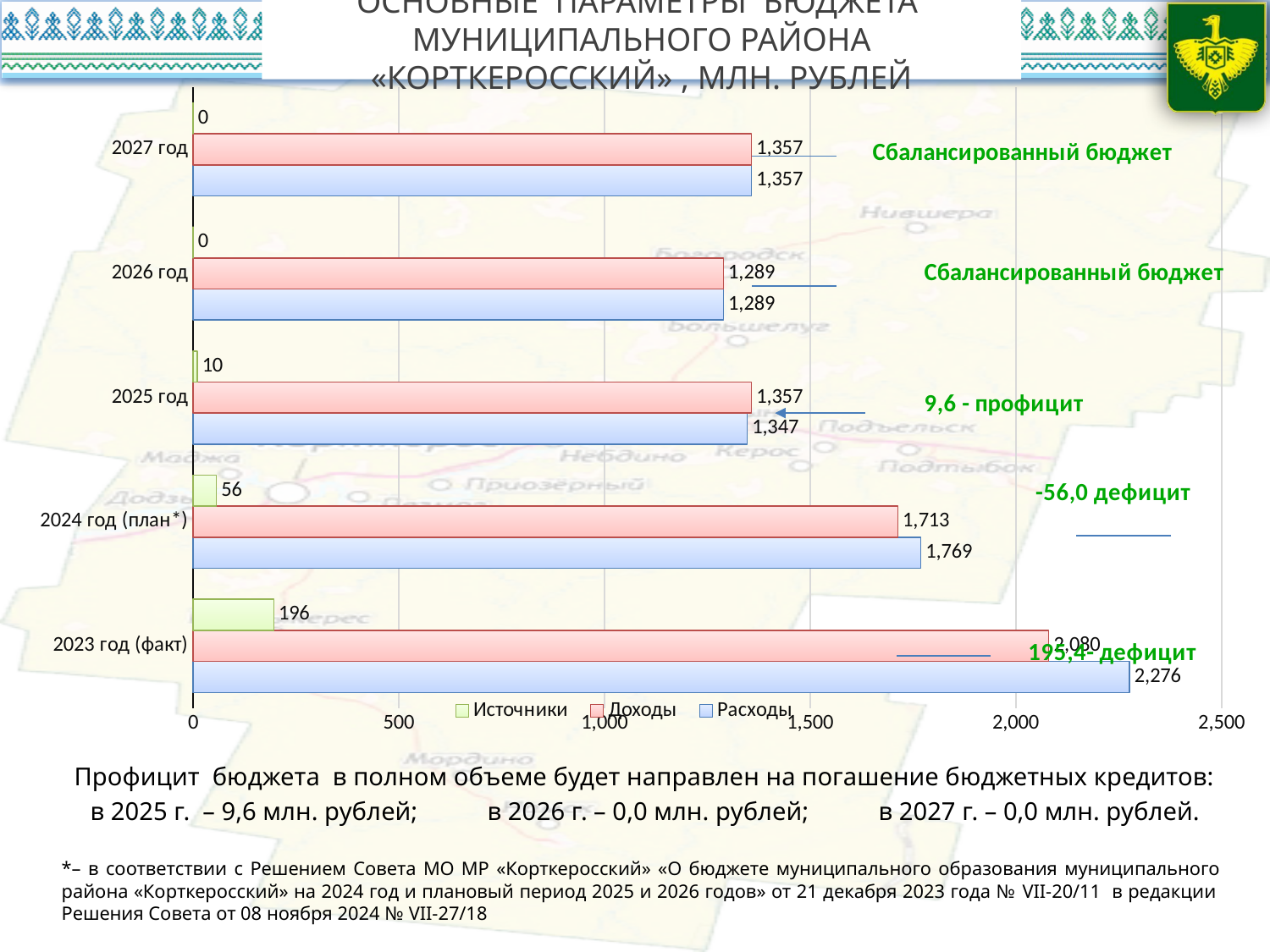
Which year has the lowest value of Доходы? 2026 год How many year categories are shown on the chart? 5 Which series is shown in green on the chart? Источники How many series does the chart legend list? 3 For 2025 год, which is larger: Доходы or Расходы? Доходы What type of chart is shown on the slide? bar chart What is the value of Доходы for 2024 год (план*)? 1,713 What is the value of Расходы for 2023 год (факт)? 2,276 Is the value of Доходы for 2024 год (план*) greater or less than 1,500? greater What is the value of Источники for 2025 год? 10 What is the difference between Расходы and Доходы for 2023 год (факт)? 196 Which year has the highest value of Расходы? 2023 год (факт)